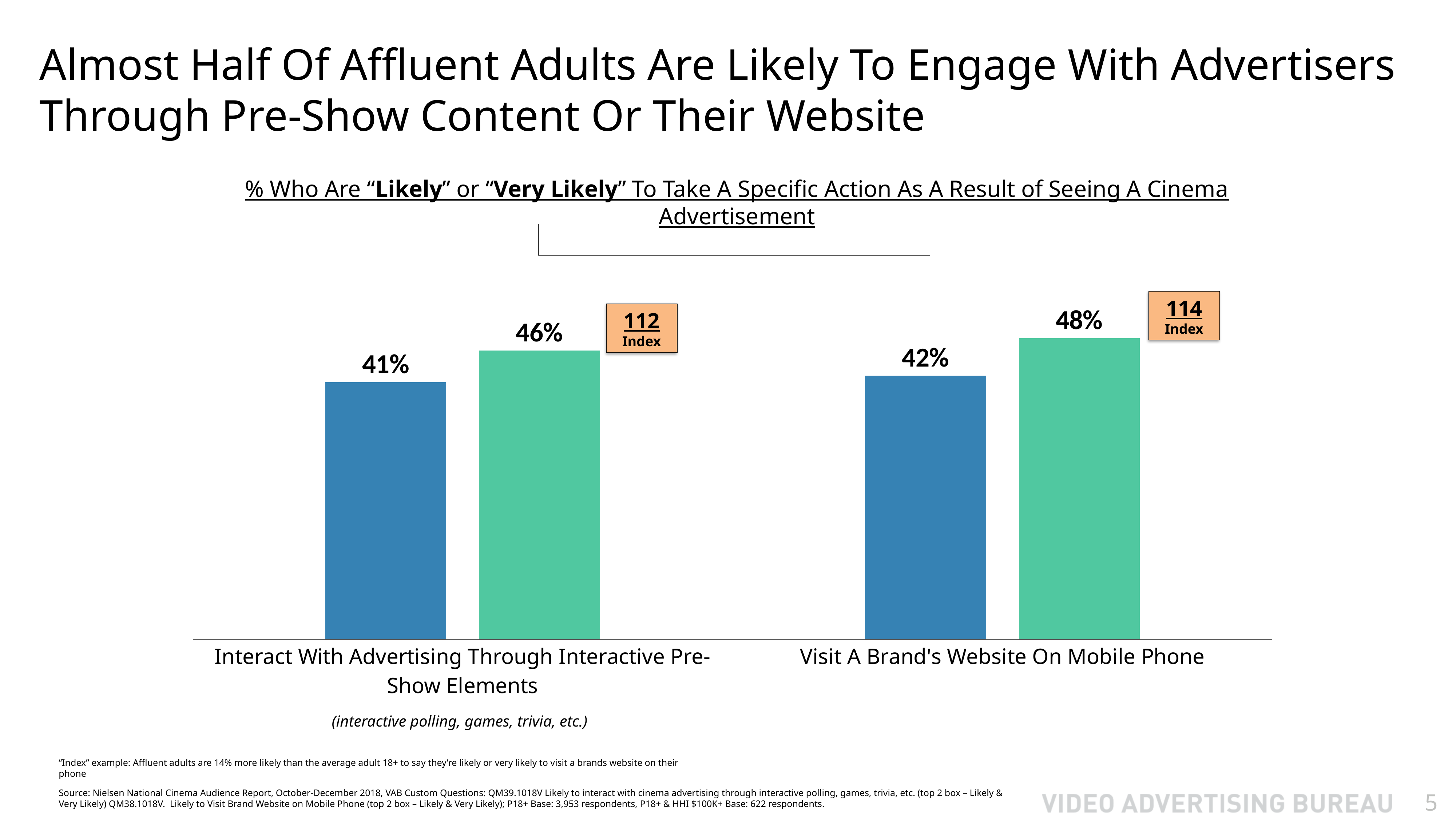
What is the value of the green bar for "Interact With Advertising Through Interactive Pre-Show Elements"? 46% What index value is shown next to the bars for "Visit A Brand's Website On Mobile Phone"? 114 What kind of chart is shown on the slide? Bar chart What is the difference between the green and blue bars for "Interact With Advertising Through Interactive Pre-Show Elements"? 5 percentage points Which is larger: the green bar for "Interact With Advertising Through Interactive Pre-Show Elements" or the green bar for "Visit A Brand's Website On Mobile Phone"? Visit A Brand's Website On Mobile Phone (48%) What is the value of the blue bar for "Visit A Brand's Website On Mobile Phone"? 42% What is the difference between the green and blue bars for "Visit A Brand's Website On Mobile Phone"? 6 percentage points Which bar on the chart has the highest value? The green bar for Visit A Brand's Website On Mobile Phone (48%) What is the value of the blue bar for "Interact With Advertising Through Interactive Pre-Show Elements"? 41% How many categories are shown on the x axis of the chart? 2 What is the value of the green bar for "Visit A Brand's Website On Mobile Phone"? 48% Which bar on the chart has the lowest value? The blue bar for Interact With Advertising Through Interactive Pre-Show Elements (41%)